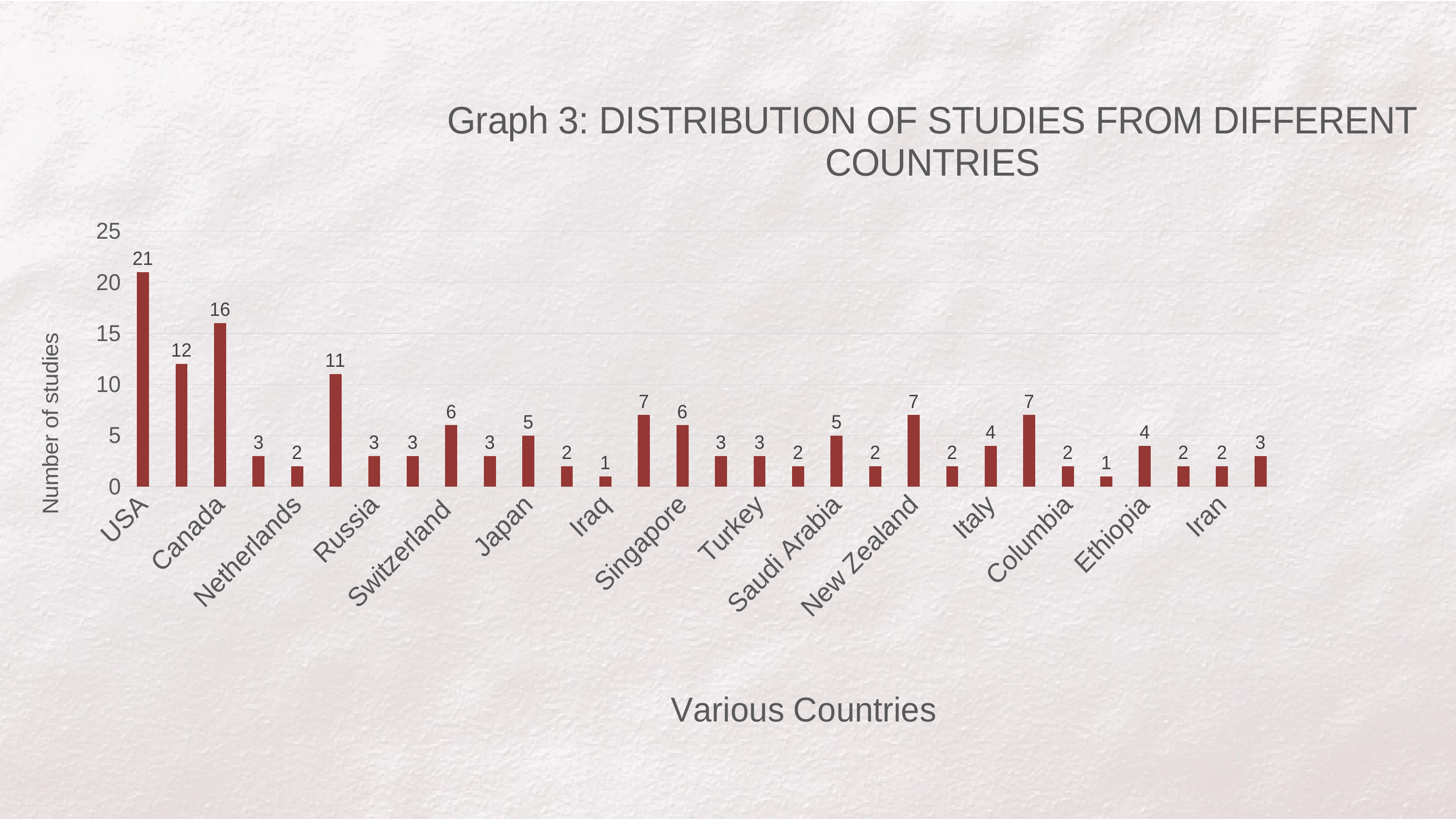
Which country has the highest number of studies? USA How many studies are from Iraq? 1 What is the title of the chart? Graph 3: DISTRIBUTION OF STUDIES FROM DIFFERENT COUNTRIES What kind of chart is shown on the slide? bar chart How many studies are from the USA? 21 How many bars are plotted in the chart? 30 What is the difference between the number of studies from the USA and from Canada? 5 How many studies are from New Zealand? 7 Which has more studies, Switzerland or Japan? Switzerland Is the value for the USA greater or less than 20? greater What is the label on the vertical axis? Number of studies How many studies are from Canada? 16